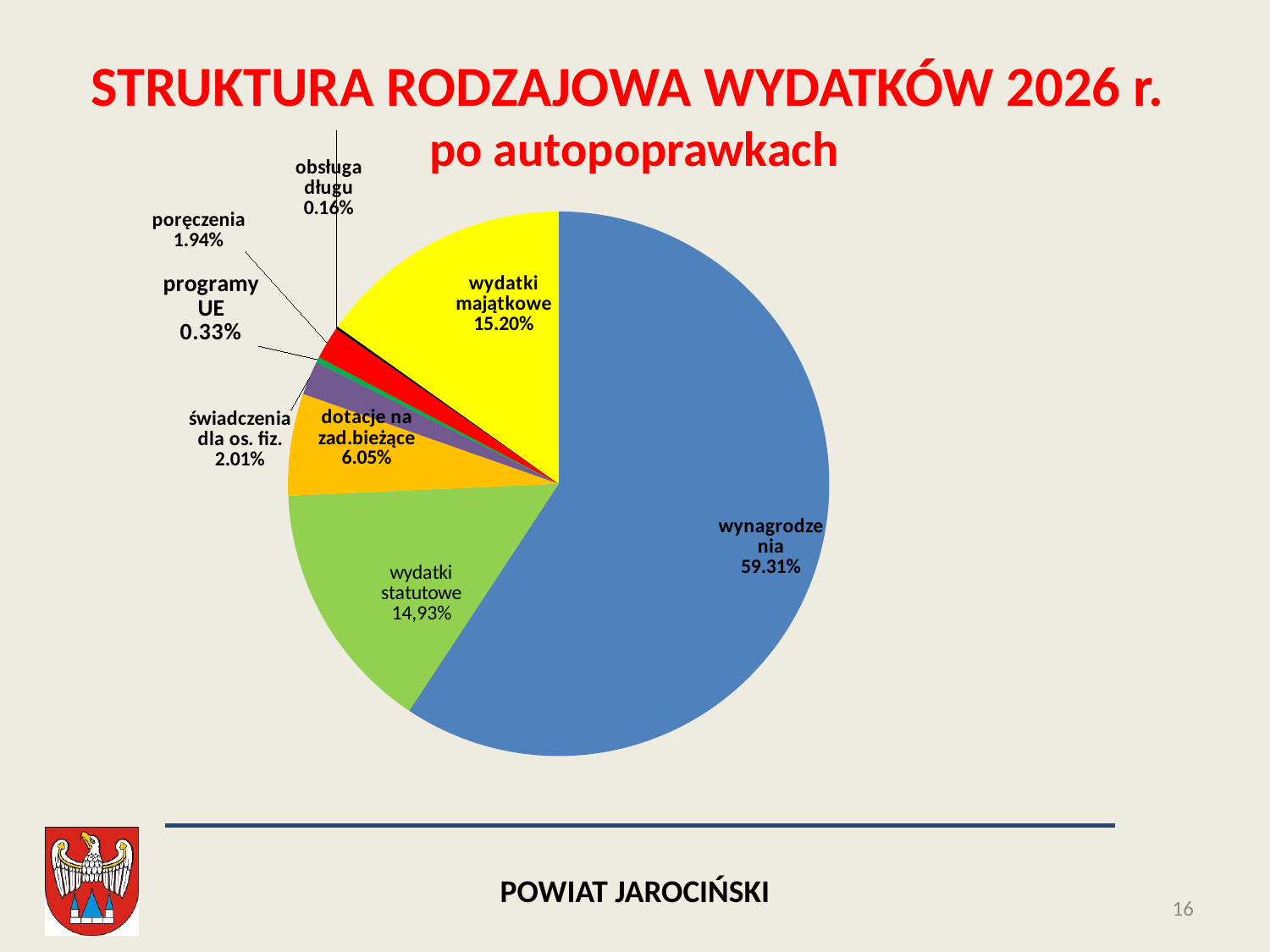
How many slices does the pie chart have? 8 What share of the pie does "wynagrodzenia" have? 59.31% What is the value shown for "obsługa długu"? 0.16% What kind of chart is shown on the slide? pie chart Which category has the largest share of the pie? wynagrodzenia What colour is the "wydatki majątkowe" slice? yellow Which is larger, "świadczenia dla os. fiz." or "programy UE"? świadczenia dla os. fiz. What is the value shown for "dotacje na zad.bieżące"? 6.05% What is the value shown for "poręczenia"? 1.94% What is the value shown for "wydatki majątkowe"? 15.20% What is the difference between the shares of "wydatki majątkowe" and "dotacje na zad.bieżące"? 9.15% Which category has the smallest share of the pie? obsługa długu